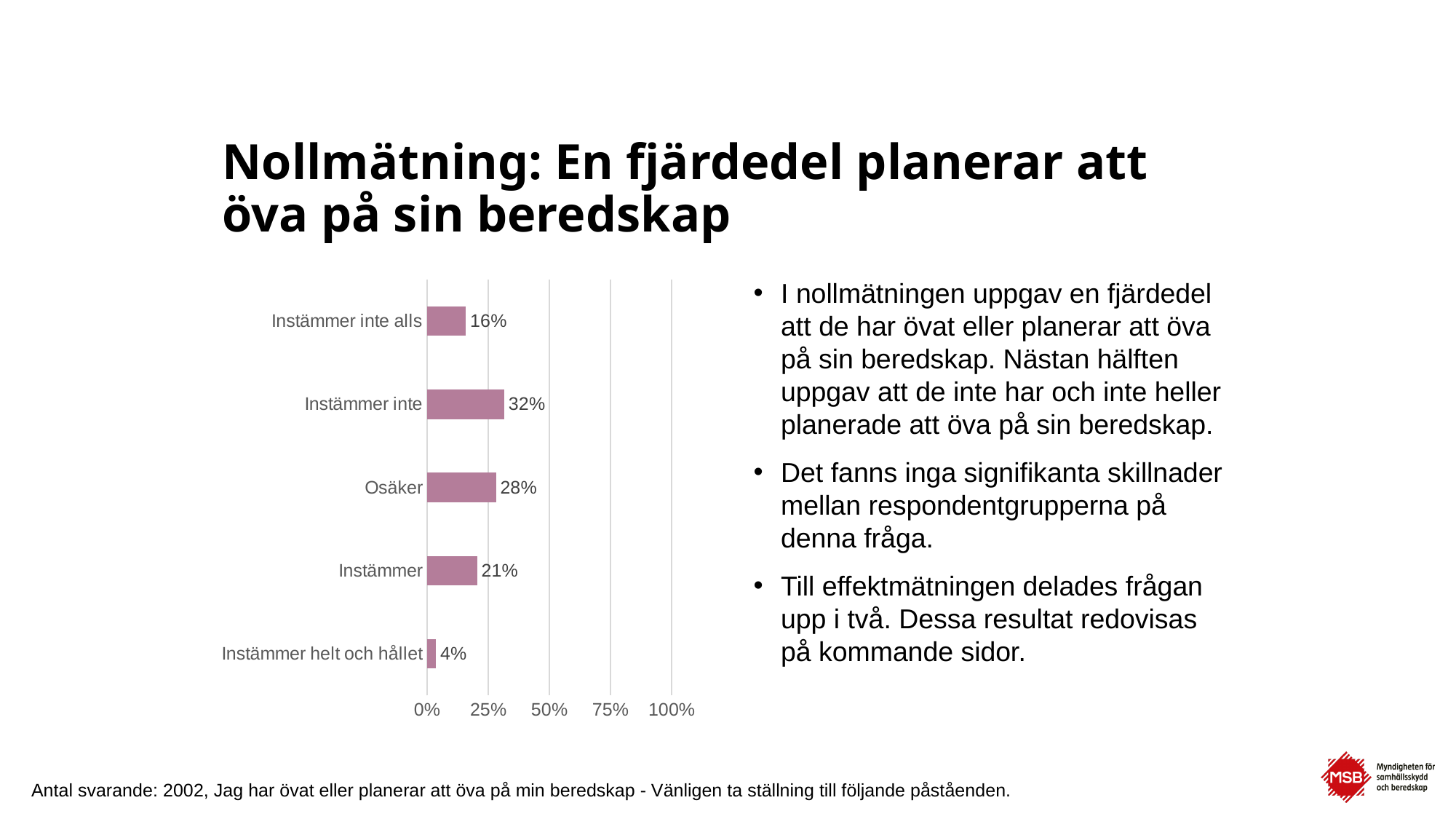
Which category has the lowest value? Instämmer helt och hållet What is the highest tick label shown on the value axis? 100% What is the value for "Instämmer inte alls"? 16% Which is larger, the value for "Osäker" or the value for "Instämmer"? Osäker What is the value for "Osäker"? 28% What is the difference between the values for "Instämmer inte" and "Instämmer"? 11% What is the combined value of "Instämmer" and "Instämmer helt och hållet"? 25% What kind of chart is shown on the slide? Bar chart What is the value for "Instämmer helt och hållet"? 4% Which category has the highest value? Instämmer inte How many categories are shown in the chart? 5 Is the value for "Instämmer inte" greater or less than 25%? greater